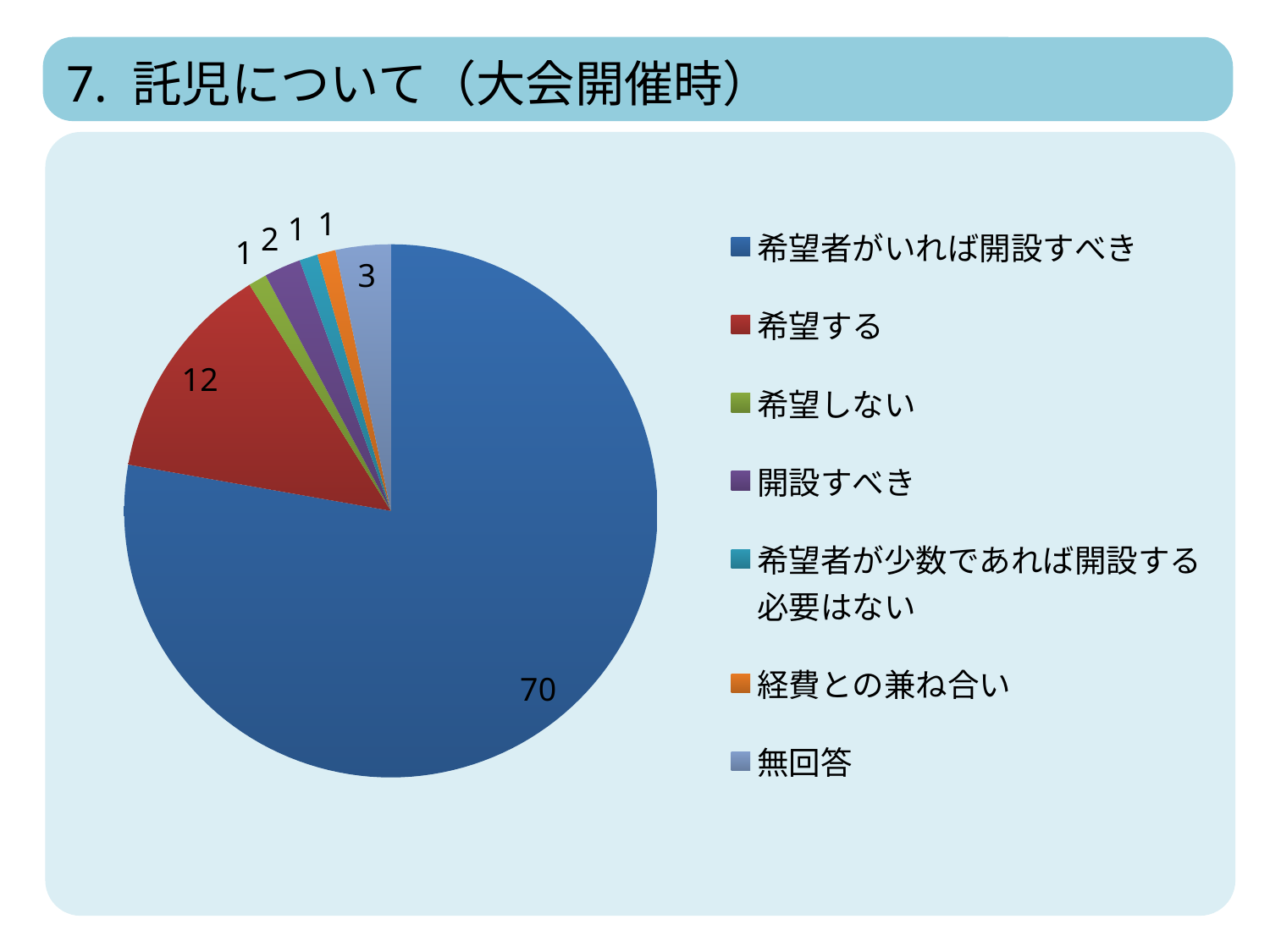
What is the value for 希望しない? 1 What colour is the slice for 経費との兼ね合い? orange What is the value for 希望する? 12 Which is larger, the value for 無回答 or the value for 開設すべき? 無回答 What is the difference between the values for 希望者がいれば開設すべき and 希望する? 58 What is the value for 開設すべき? 2 How many categories does the legend list? 7 What is the value for 希望者がいれば開設すべき? 70 What is the total of all the values shown on the pie chart? 90 Which category has the largest slice of the pie? 希望者がいれば開設すべき What is the value for 無回答? 3 What kind of chart is shown on the slide? pie chart